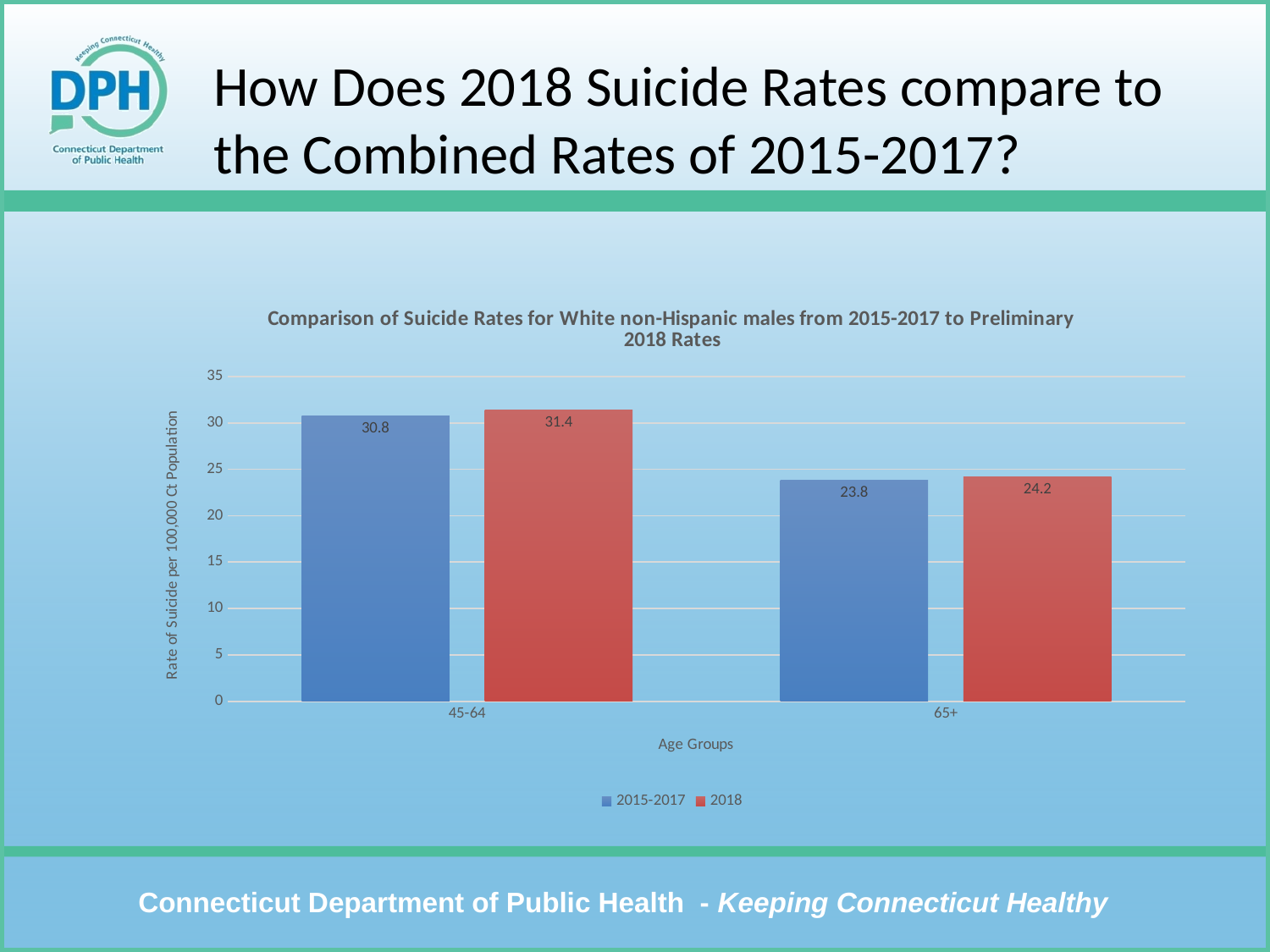
What kind of chart is shown on the slide? Bar chart What is the 2018 suicide rate for the 65+ age group? 24.2 Which age group has the highest 2018 suicide rate? 45-64 What is the label of the y axis? Rate of Suicide per 100,000 Ct Population What is the 2015-2017 suicide rate for the 45-64 age group? 30.8 How many series does the legend list? 2 What is the difference between the 45-64 and 65+ rates for 2015-2017? 7 Which age group has the lowest 2015-2017 suicide rate? 65+ What is the difference between the 2018 rate and the 2015-2017 rate for the 45-64 age group? 0.6 Which is larger for the 65+ age group, the 2015-2017 rate or the 2018 rate? 2018 What is the 2015-2017 suicide rate for the 65+ age group? 23.8 How many age groups are shown on the x axis? 2